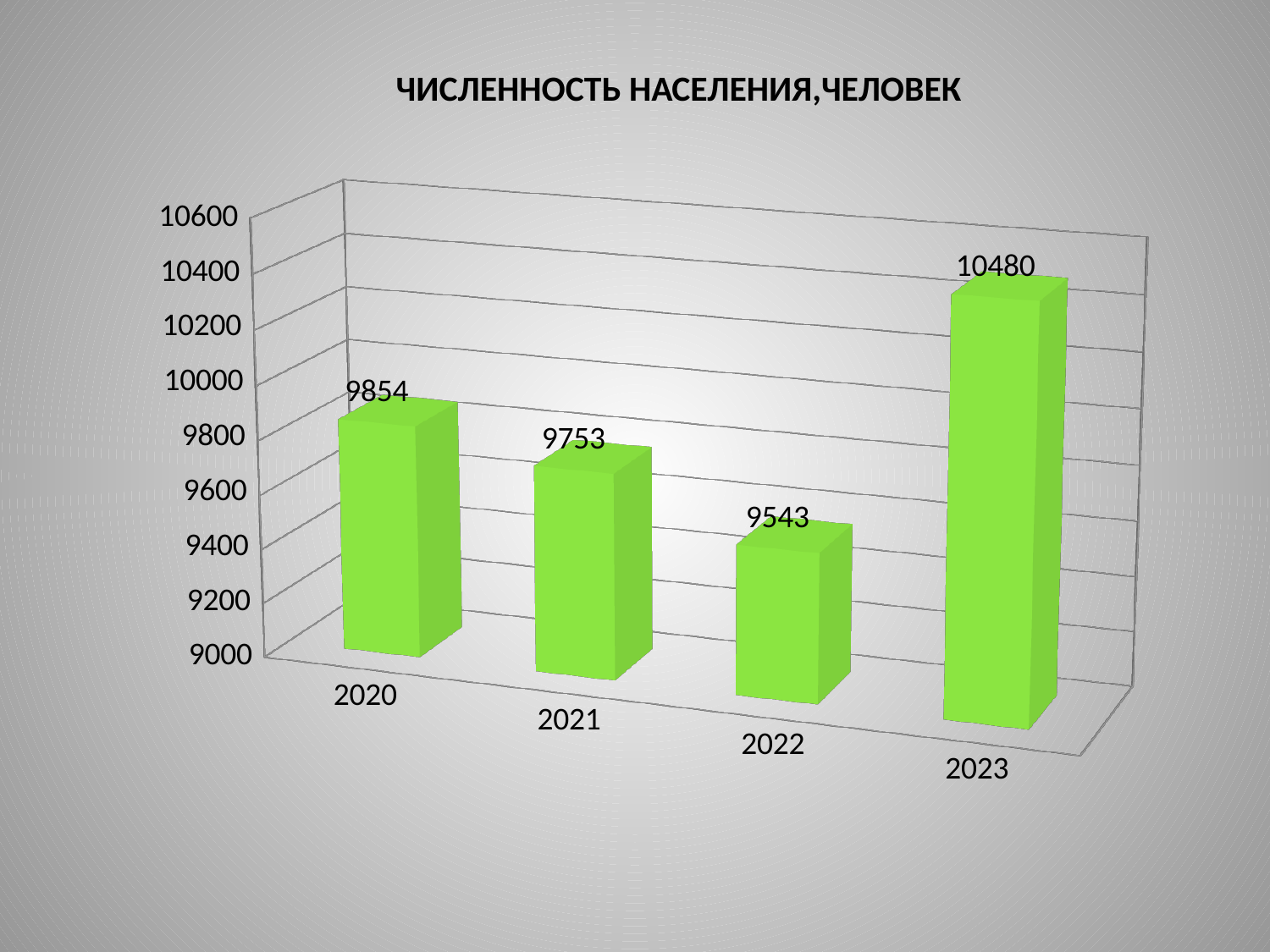
Is the value for 2023 greater or less than 10000? greater What is the population value shown for 2023? 10480 How many years are shown on the chart? 4 What is the population value shown for 2022? 9543 What is the population value shown for 2020? 9854 What is the difference between the population values for 2020 and 2021? 101 Which year has the highest population value? 2023 What kind of chart is shown on the slide? bar chart Which is larger, the value for 2021 or the value for 2022? 2021 What is the difference between the population values for 2023 and 2022? 937 Which year has the lowest population value? 2022 What is the title of the chart? ЧИСЛЕННОСТЬ НАСЕЛЕНИЯ,ЧЕЛОВЕК